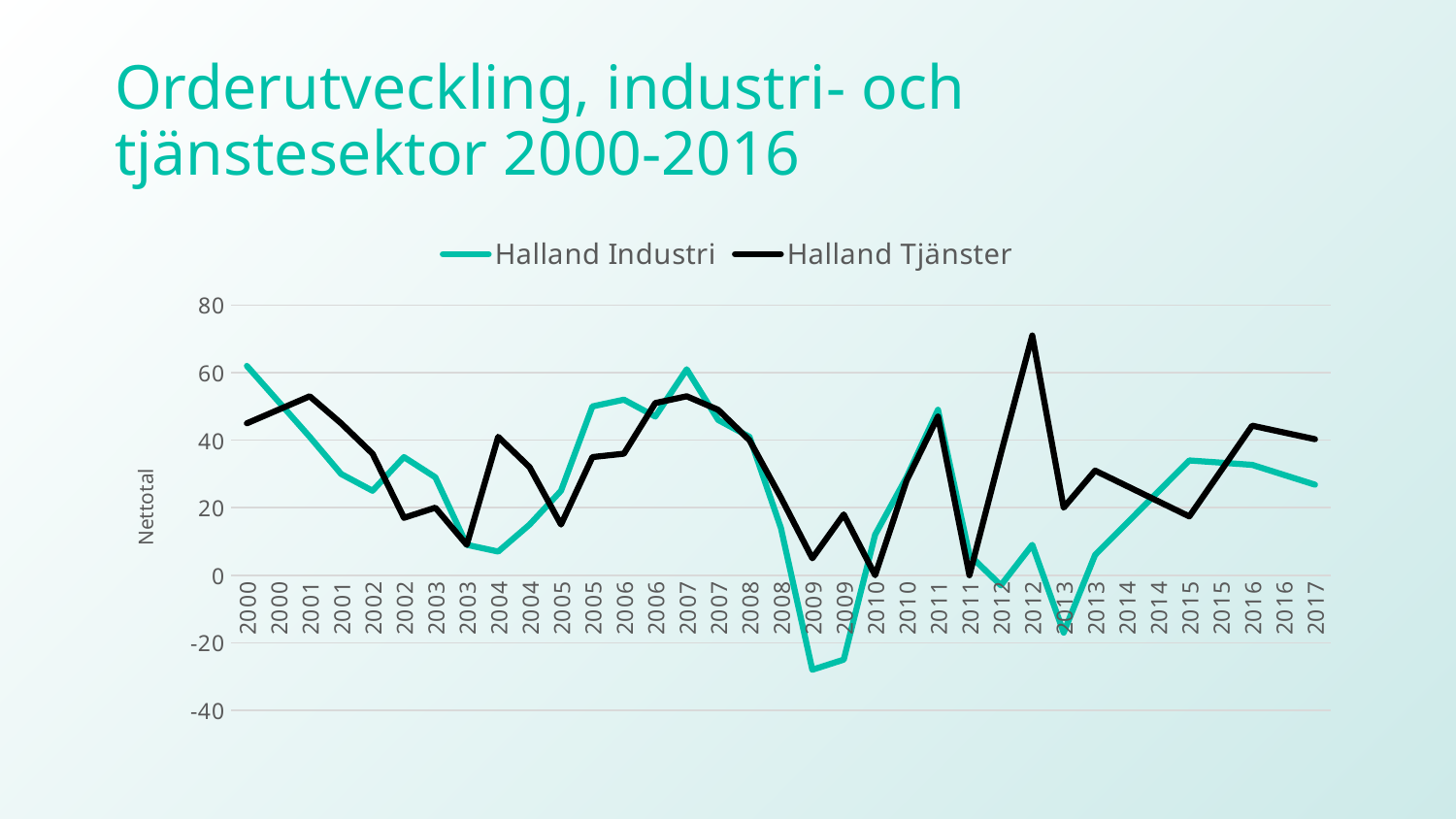
Which series reaches the highest value anywhere on the chart? Halland Tjänster Is the peak value of Halland Tjänster in 2012 greater or less than 60? greater What kind of chart is shown on the slide? Line chart What are the two series named in the legend? Halland Industri and Halland Tjänster Is the value for Halland Industri at the first 2000 point greater or less than 40? greater Is the lowest value of Halland Industri (in 2009) greater or less than -20? less How many series does the legend list? 2 Does the Halland Industri line rise or fall from 2000 to 2003? fall Which series reaches the lowest value anywhere on the chart? Halland Industri At the second 2012 point, which series has the larger value, Halland Industri or Halland Tjänster? Halland Tjänster What is the label on the vertical axis? Nettotal At the first 2000 point, which series has the larger value, Halland Industri or Halland Tjänster? Halland Industri